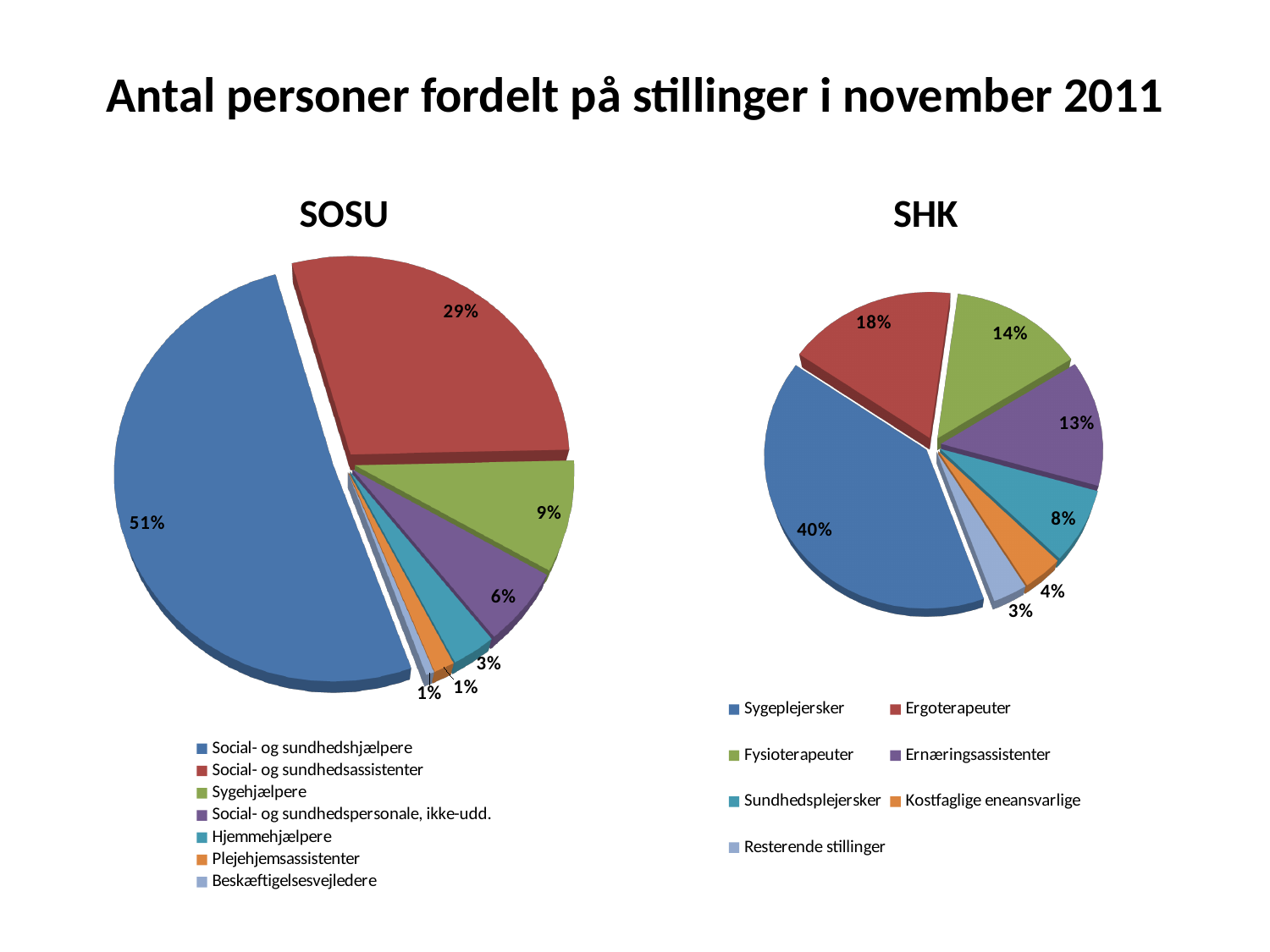
In the SOSU chart, what share do Social- og sundhedshjælpere have? 51% In the SHK chart, what share do Sygeplejersker have? 40% In the SHK chart, what is the difference between the shares of Sygeplejersker and Ergoterapeuter? 22% In the SHK chart, what share do Ernæringsassistenter have? 13% In the SOSU chart, which category has the largest share? Social- og sundhedshjælpere In the SOSU chart, how many categories does the legend list? 7 In the SHK chart, which category has the smallest share? Resterende stillinger What kind of chart is the SHK chart? Pie chart What is the title of the slide? Antal personer fordelt på stillinger i november 2011 In the SHK chart, which is larger: Ergoterapeuter or Fysioterapeuter? Ergoterapeuter In the SOSU chart, what is the difference between the shares of Sygehjælpere and Hjemmehjælpere? 6%